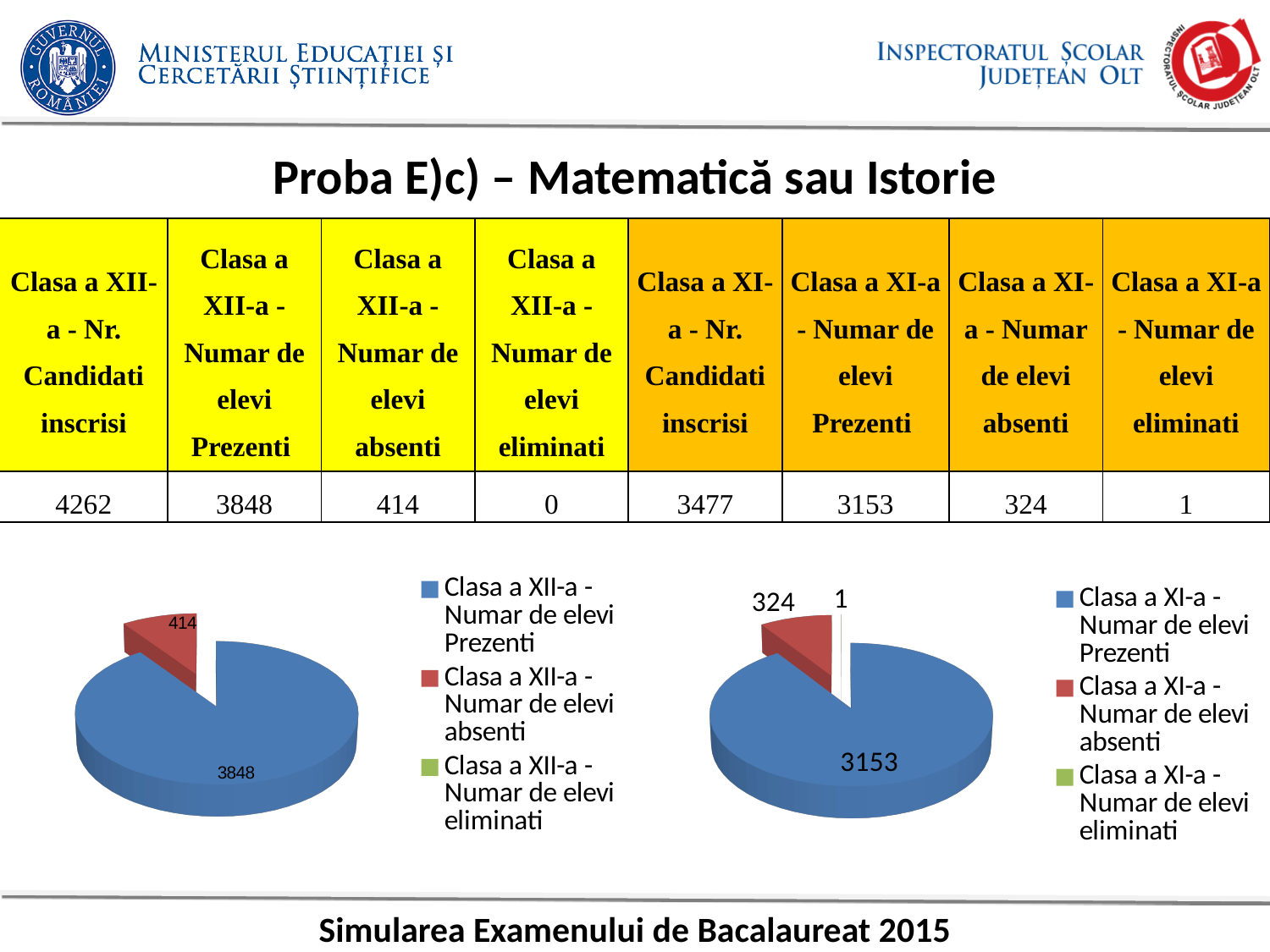
On the left pie chart (Clasa a XII-a), which category has the largest slice? Clasa a XII-a - Numar de elevi Prezenti On the right pie chart (Clasa a XI-a), what is the difference between the Prezenti value and the absenti value? 2829 How many entries does the legend of the right pie chart (Clasa a XI-a) list? 3 On the left pie chart (Clasa a XII-a), what value is shown for Numar de elevi Prezenti? 3848 On the right pie chart (Clasa a XI-a), which category has the smallest slice? Clasa a XI-a - Numar de elevi eliminati On the right pie chart (Clasa a XI-a), what value is shown for Numar de elevi eliminati? 1 On the right pie chart (Clasa a XI-a), what value is shown for Numar de elevi Prezenti? 3153 On the left pie chart (Clasa a XII-a), what value is shown for Numar de elevi absenti? 414 On the left pie chart (Clasa a XII-a), what is the difference between the Prezenti value and the absenti value? 3434 What type of chart is used on the left side of the slide for Clasa a XII-a? pie chart On the right pie chart (Clasa a XI-a), what value is shown for Numar de elevi absenti? 324 Is the Prezenti value on the left pie chart (3848) larger or smaller than the Prezenti value on the right pie chart (3153)? larger